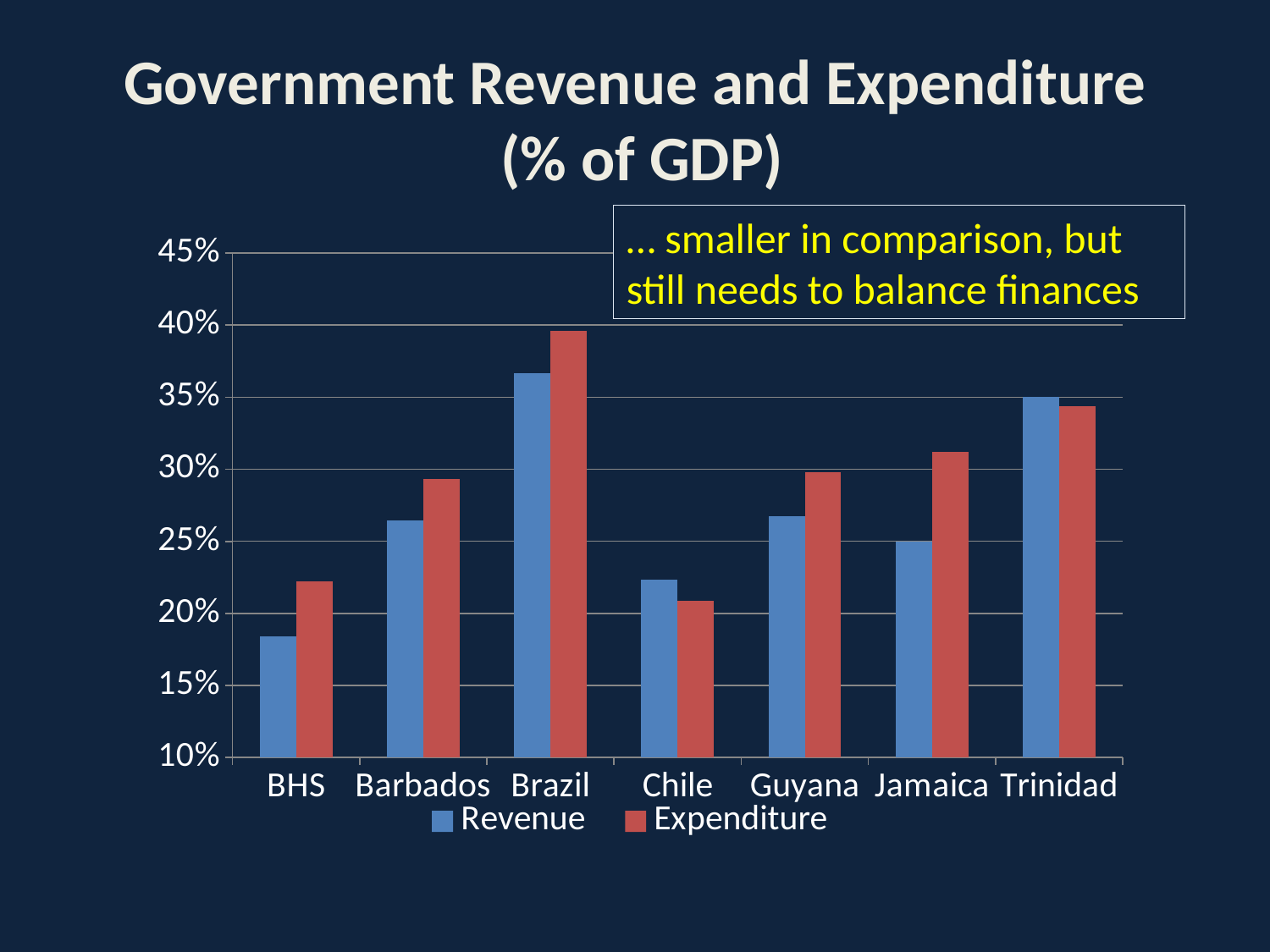
For Jamaica, which is larger, Revenue or Expenditure? Expenditure Which country has the lowest Revenue bar? BHS How many countries are shown on the x axis of the chart? 7 Is the Revenue value for BHS greater or less than 20%? less Which colour represents Expenditure in the chart? red How many series does the legend list? 2 Which country has the lowest Expenditure bar? Chile Is the Expenditure value for Brazil greater or less than 35%? greater Which country has the highest Expenditure bar? Brazil For Chile, which is larger, Revenue or Expenditure? Revenue What kind of chart is shown on the slide? bar chart Which country has the highest Revenue bar? Brazil